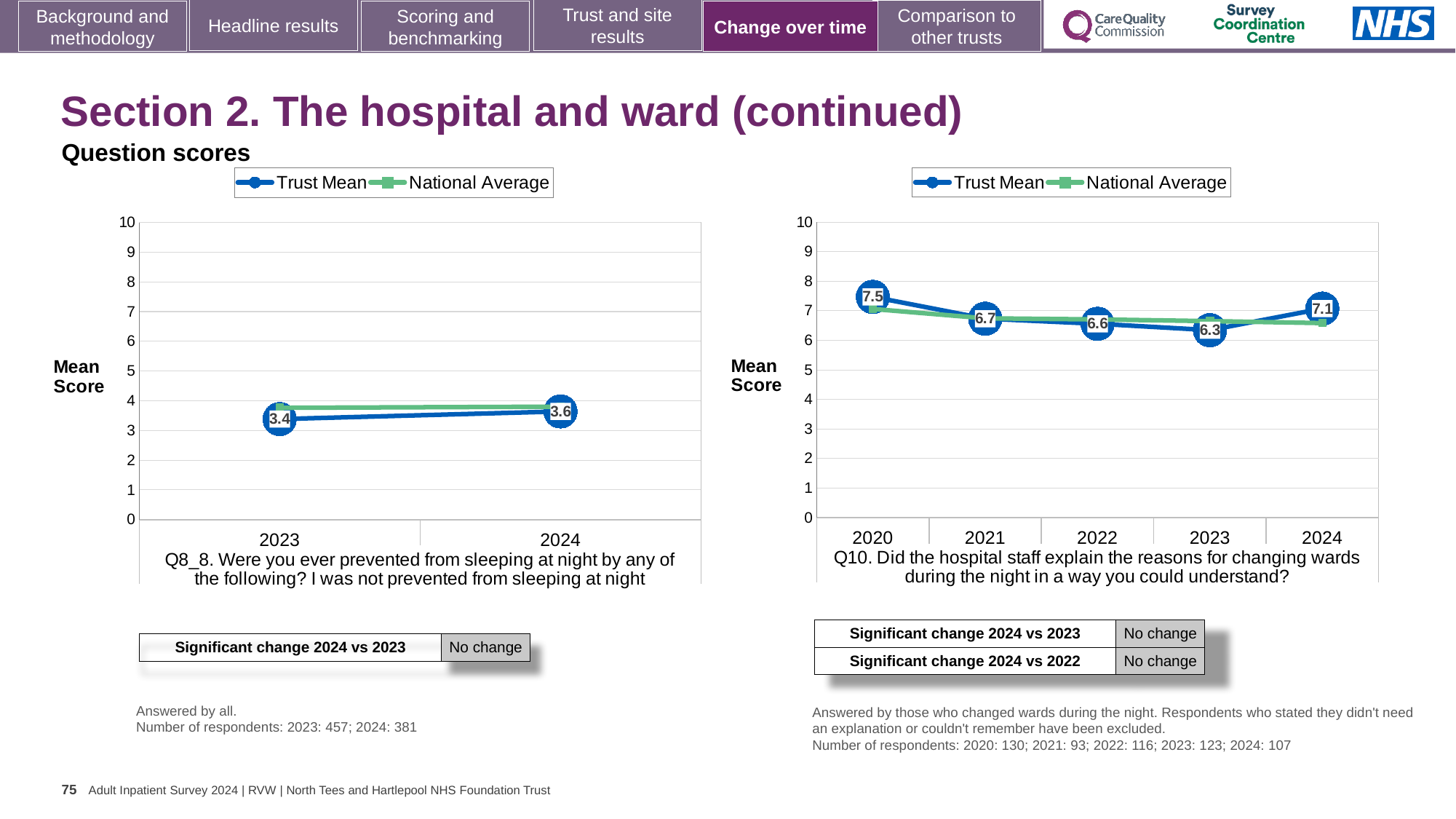
In the right chart (Q10), which year has the lowest Trust Mean? 2023 In the right chart (Q10), what is the Trust Mean for 2020? 7.5 In the right chart (Q10), what is the Trust Mean for 2023? 6.3 In the right chart (Q10), which year has the highest Trust Mean? 2020 In the right chart (Q10), is the Trust Mean for 2021 greater or less than 6? greater In the left chart (Q8_8), does the Trust Mean rise or fall from 2023 to 2024? rise In the left chart (Q8_8), what is the Trust Mean for 2023? 3.4 In the right chart (Q10), what is the difference between the Trust Mean for 2024 and 2023? 0.8 In the left chart (Q8_8), what is the Trust Mean for 2024? 3.6 In the right chart (Q10), how many years are plotted on the x axis? 5 How many series does the legend of the left chart (Q8_8) list? 2 In the left chart (Q8_8), what is the difference between the Trust Mean for 2024 and 2023? 0.2